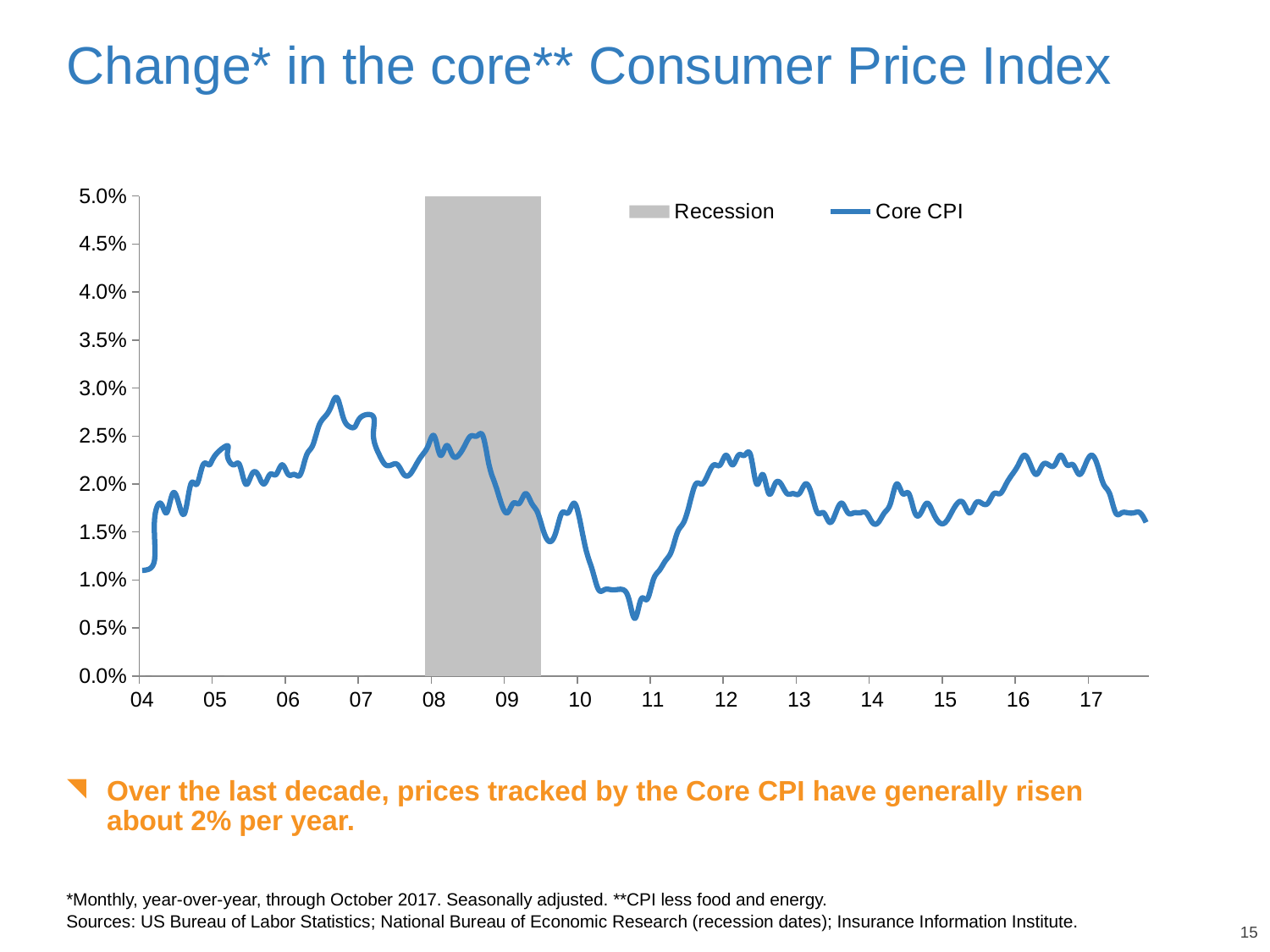
What does the grey shaded area on the chart represent? Recession How many entries does the chart legend list? 2 Is the Core CPI value in early 2012 greater or less than 2.0%? greater Is the Core CPI peak reached in late 2006 greater or less than 2.5%? greater Does the Core CPI line rise or fall between 2009 and late 2010? fall Is the Core CPI value at the end of the series in 2017 greater or less than 2.0%? less In which year does the Core CPI line reach its lowest point? 2010 Does the Core CPI line rise or fall from late 2010 to early 2012? rise What is the title of the chart on the slide? Change* in the core** Consumer Price Index What kind of chart is shown on the slide? Line chart